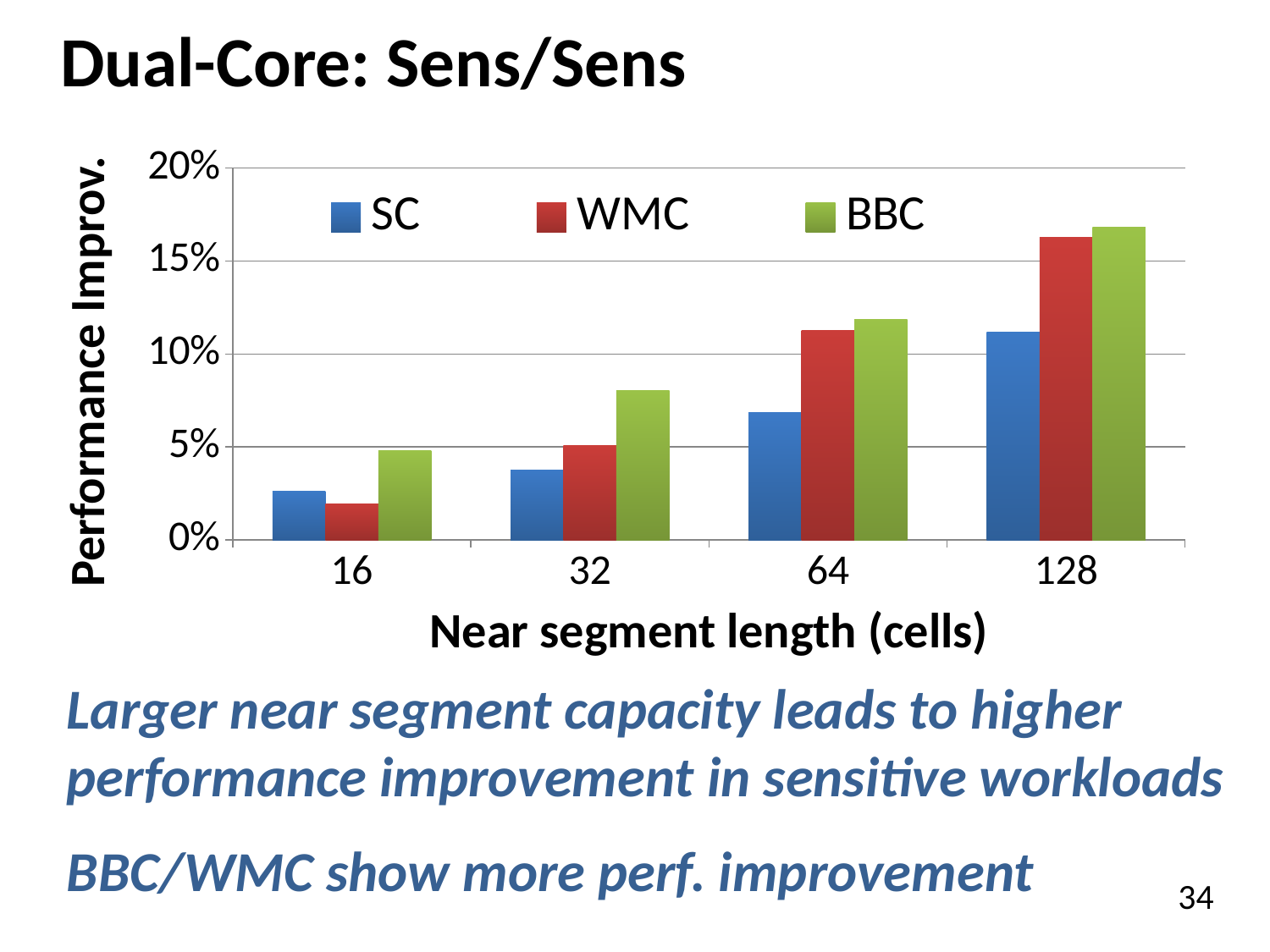
Is the BBC value at near segment length 128 greater or less than 15%? greater Is the SC value at near segment length 128 greater or less than 10%? greater How many near segment length categories are shown on the x axis? 4 At which near segment length does BBC reach its highest performance improvement? 128 Do the SC values rise or fall as near segment length increases from 16 to 128? rise What is the label of the x axis? Near segment length (cells) How many series does the legend list? 3 Is the BBC value at near segment length 32 greater or less than 10%? less What kind of chart is shown on the slide? bar chart At near segment length 16, which series has the larger value, SC or WMC? SC